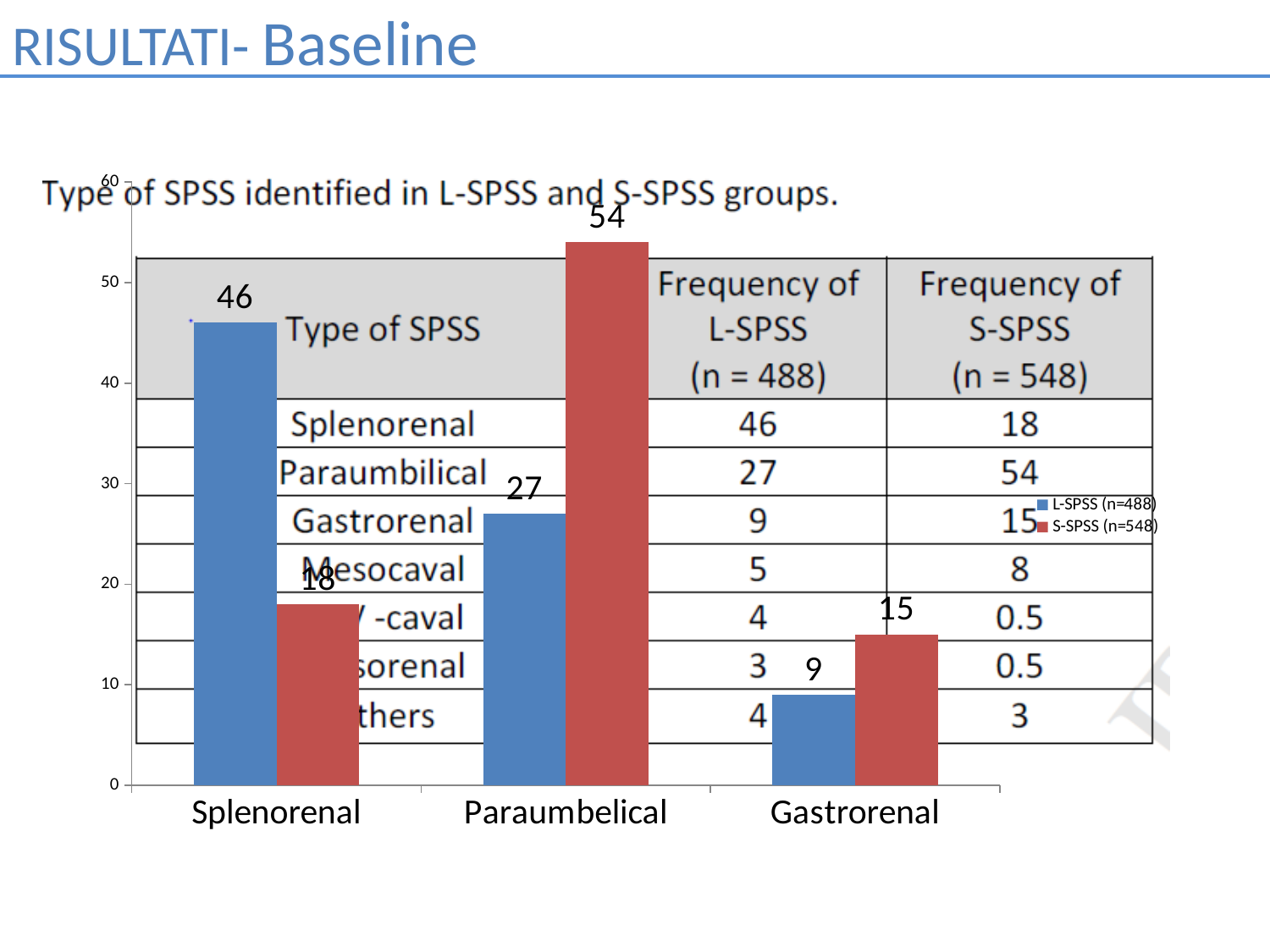
For Paraumbelical, which series has the larger value in the bar chart, L-SPSS (n=488) or S-SPSS (n=548)? S-SPSS (n=548) How many series does the legend of the bar chart list? 2 Which colour represents the S-SPSS (n=548) series in the bar chart? red What is the difference between the L-SPSS (n=488) and S-SPSS (n=548) values for Splenorenal in the bar chart? 28 How many categories are shown on the x axis of the bar chart? 3 What is the L-SPSS (n=488) value for Gastrorenal in the bar chart? 9 Which category has the highest S-SPSS (n=548) value in the bar chart? Paraumbelical What is the S-SPSS (n=548) value for Gastrorenal in the bar chart? 15 What is the S-SPSS (n=548) value for Paraumbelical in the bar chart? 54 What is the L-SPSS (n=488) value for Splenorenal in the bar chart? 46 Which category has the lowest L-SPSS (n=488) value in the bar chart? Gastrorenal What kind of chart is shown on the slide? bar chart